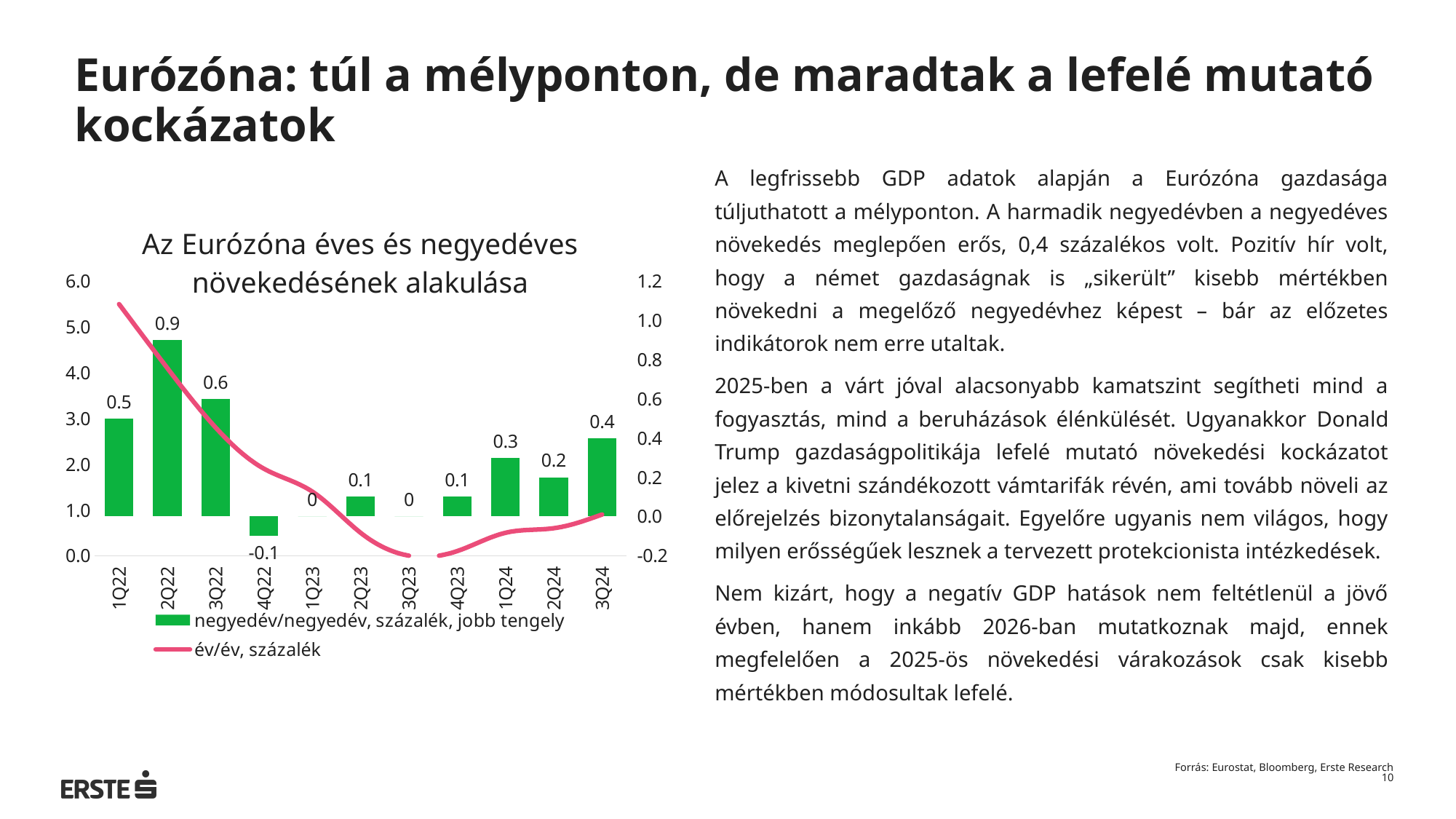
Which is larger, the quarter-on-quarter growth bar for 1Q24 or for 2Q24? 1Q24 How many quarters are shown on the x axis of the chart? 11 Which quarter has the highest quarter-on-quarter growth bar? 2Q22 What is the quarter-on-quarter growth value shown for 4Q22? -0.1 What is the difference between the quarter-on-quarter growth values for 2Q22 and 3Q24? 0.5 What is the overall trend of the year-on-year growth line from 1Q22 to 3Q23? falling What is the quarter-on-quarter growth value shown for 2Q22? 0.9 What is the quarter-on-quarter growth value shown for 3Q24? 0.4 How many series does the chart legend list? 2 Is the year-on-year growth line value for 1Q22 greater or less than 5.0? greater Is the year-on-year growth line value for 3Q23 greater or less than 1.0? less Which quarter has the lowest quarter-on-quarter growth bar? 4Q22